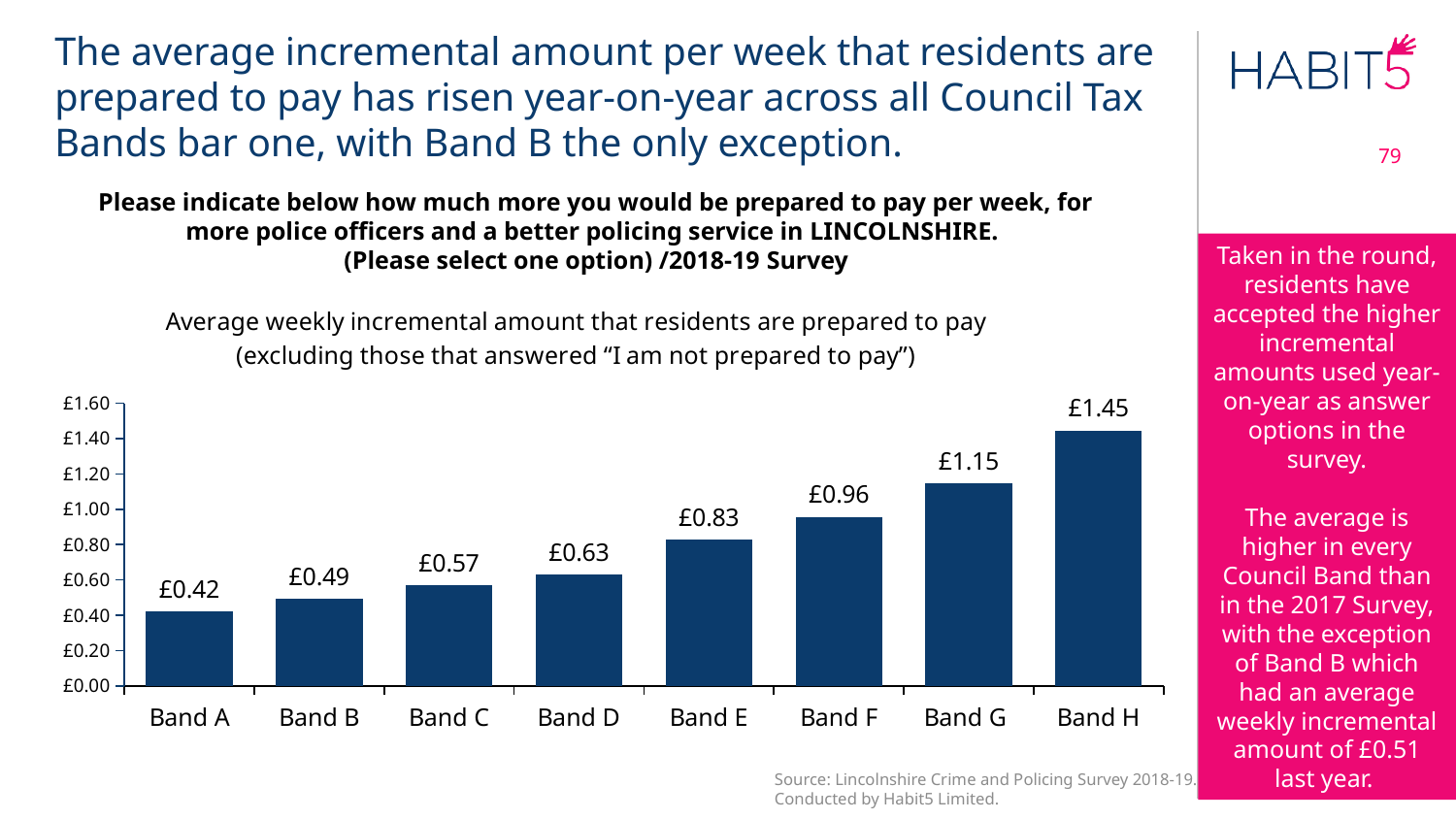
Which is larger, the average weekly incremental amount for Band C or for Band E? Band E What is the difference between the average weekly incremental amounts for Band H and Band A? £1.03 What is the difference between the average weekly incremental amounts for Band G and Band E? £0.32 Which Council Tax Band has the lowest average weekly incremental amount? Band A How many Council Tax Bands are shown on the chart? 8 What is the average weekly incremental amount for Band A? £0.42 Which Council Tax Band has the highest average weekly incremental amount? Band H Is the value for Band G greater or less than £1.00? greater What kind of chart is used to show the average weekly incremental amounts? Bar chart Do the values rise or fall moving from Band A to Band H along the x axis? Rise What is the average weekly incremental amount for Band D? £0.63 What is the average weekly incremental amount for Band F? £0.96